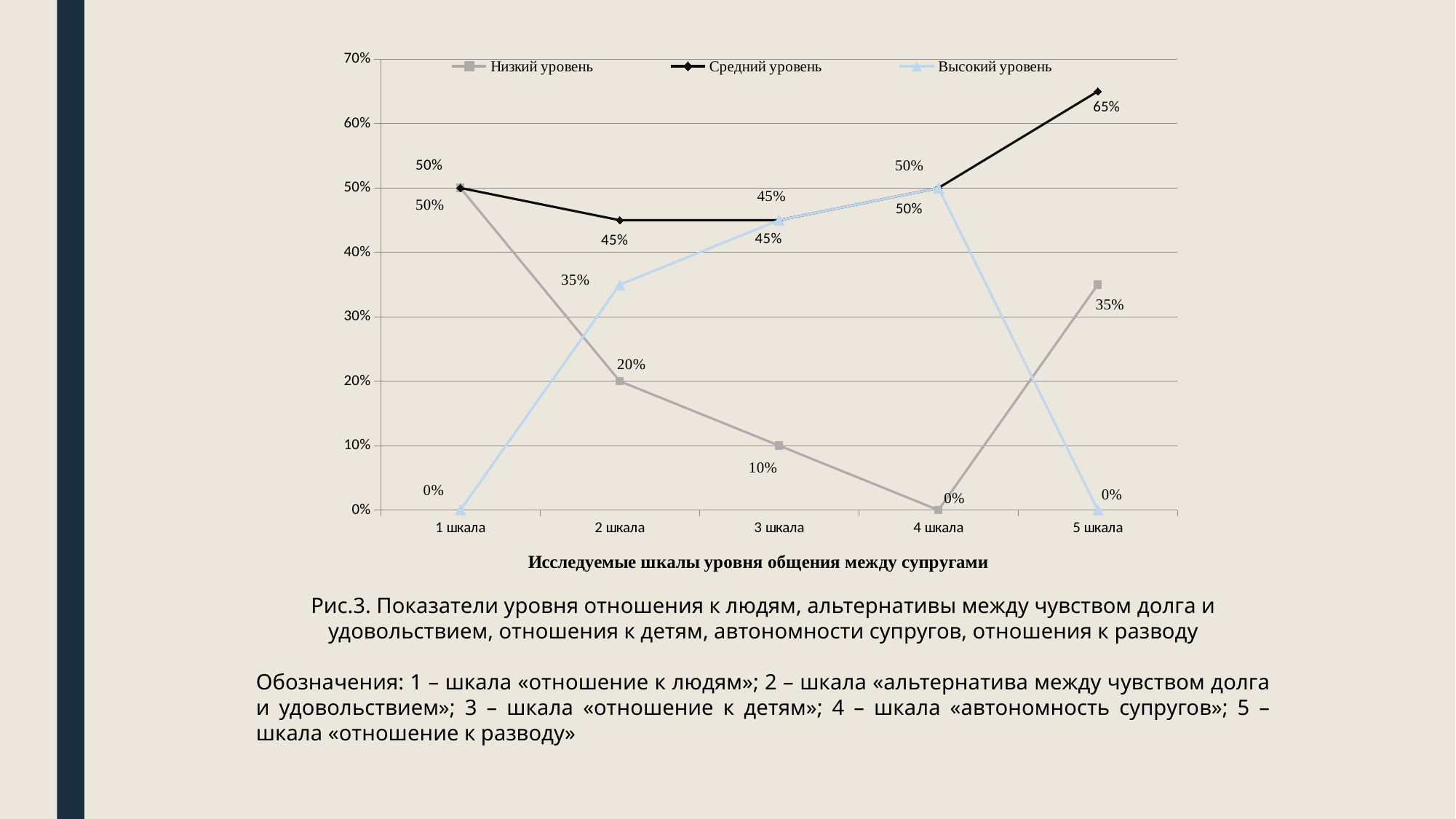
What is the value of Низкий уровень for 2 шкала? 20% What is the value of Средний уровень for 5 шкала? 65% What is the difference between Средний уровень and Низкий уровень for 5 шкала? 30% For which category is Средний уровень highest? 5 шкала What type of chart is shown on the slide? line chart Which is larger for 2 шкала: Средний уровень or Высокий уровень? Средний уровень For which category is Низкий уровень lowest? 4 шкала How many series does the legend list? 3 How many categories are shown on the x axis? 5 What is the value of Низкий уровень for 3 шкала? 10% What is the value of Высокий уровень for 2 шкала? 35% What is the x-axis title of the chart? Исследуемые шкалы уровня общения между супругами